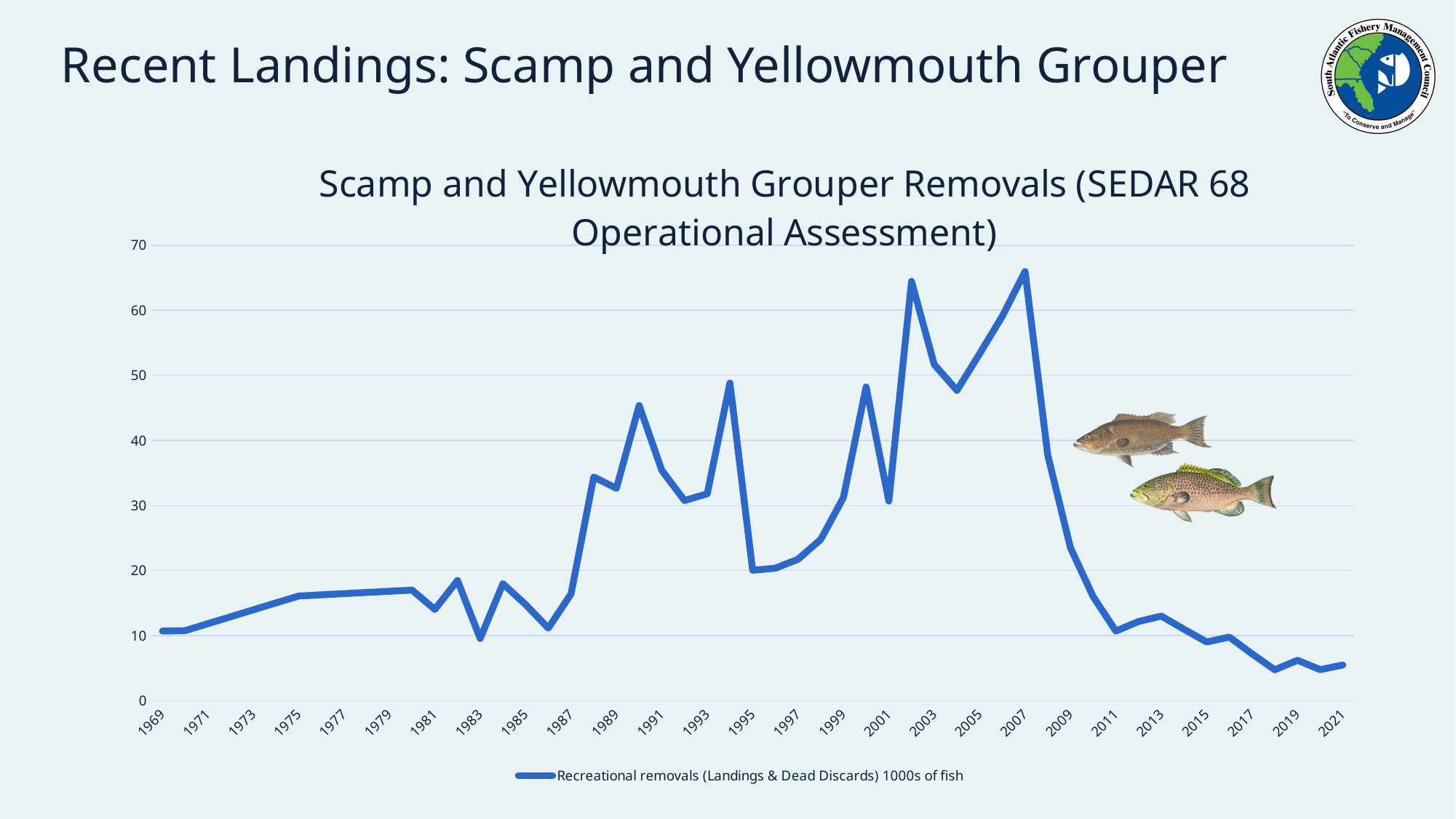
Is the value for 2021 greater or less than 10? less Is the value for 1969 greater or less than 20? less Which year has the larger value, 2007 or 2021? 2007 What is the legend entry for the plotted series? Recreational removals (Landings & Dead Discards) 1000s of fish How many series does the legend list? 1 Do the values rise or fall between 1969 and 1975? Rise What kind of chart is shown on the slide? Line chart Is the value for 2007 greater or less than 60? greater Do the values rise or fall between 2007 and 2011? Fall What is the title of the chart? Scamp and Yellowmouth Grouper Removals (SEDAR 68 Operational Assessment)